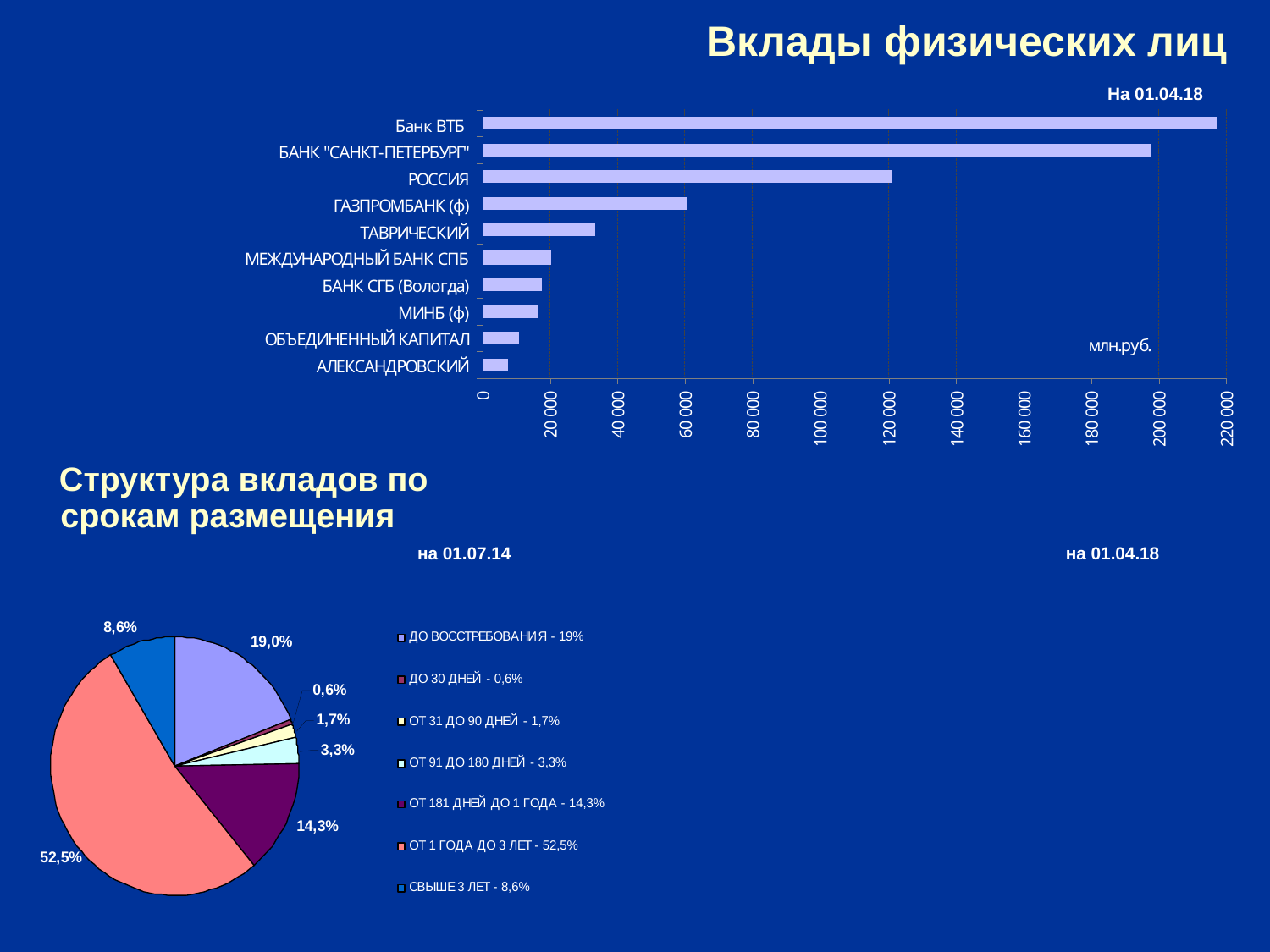
In the pie chart "Структура вкладов по срокам размещения", how many categories does the legend list? 7 In the top bar chart "Вклады физических лиц", is the value for Банк ВТБ greater or less than 200 000? greater In the top bar chart "Вклады физических лиц", which bank has the lowest value? АЛЕКСАНДРОВСКИЙ In the pie chart "Структура вкладов по срокам размещения", which category has the smallest share? ДО 30 ДНЕЙ In the pie chart "Структура вкладов по срокам размещения", what share is ОТ 1 ГОДА ДО 3 ЛЕТ? 52,5% In the top bar chart "Вклады физических лиц", which is larger: the value for ГАЗПРОМБАНК (ф) or the value for ТАВРИЧЕСКИЙ? ГАЗПРОМБАНК (ф) In the top bar chart "Вклады физических лиц", is the value for РОССИЯ greater or less than 100 000? greater In the pie chart "Структура вкладов по срокам размещения", what is the difference between the shares of ДО ВОССТРЕБОВАНИЯ and ОТ 181 ДНЕЙ ДО 1 ГОДА? 4,7% In the top bar chart "Вклады физических лиц", is the value for ТАВРИЧЕСКИЙ greater or less than 40 000? less In the top bar chart "Вклады физических лиц", which bank has the highest value? Банк ВТБ In the top bar chart "Вклады физических лиц", how many banks are shown? 10 What kind of chart is the top chart titled "Вклады физических лиц"? bar chart